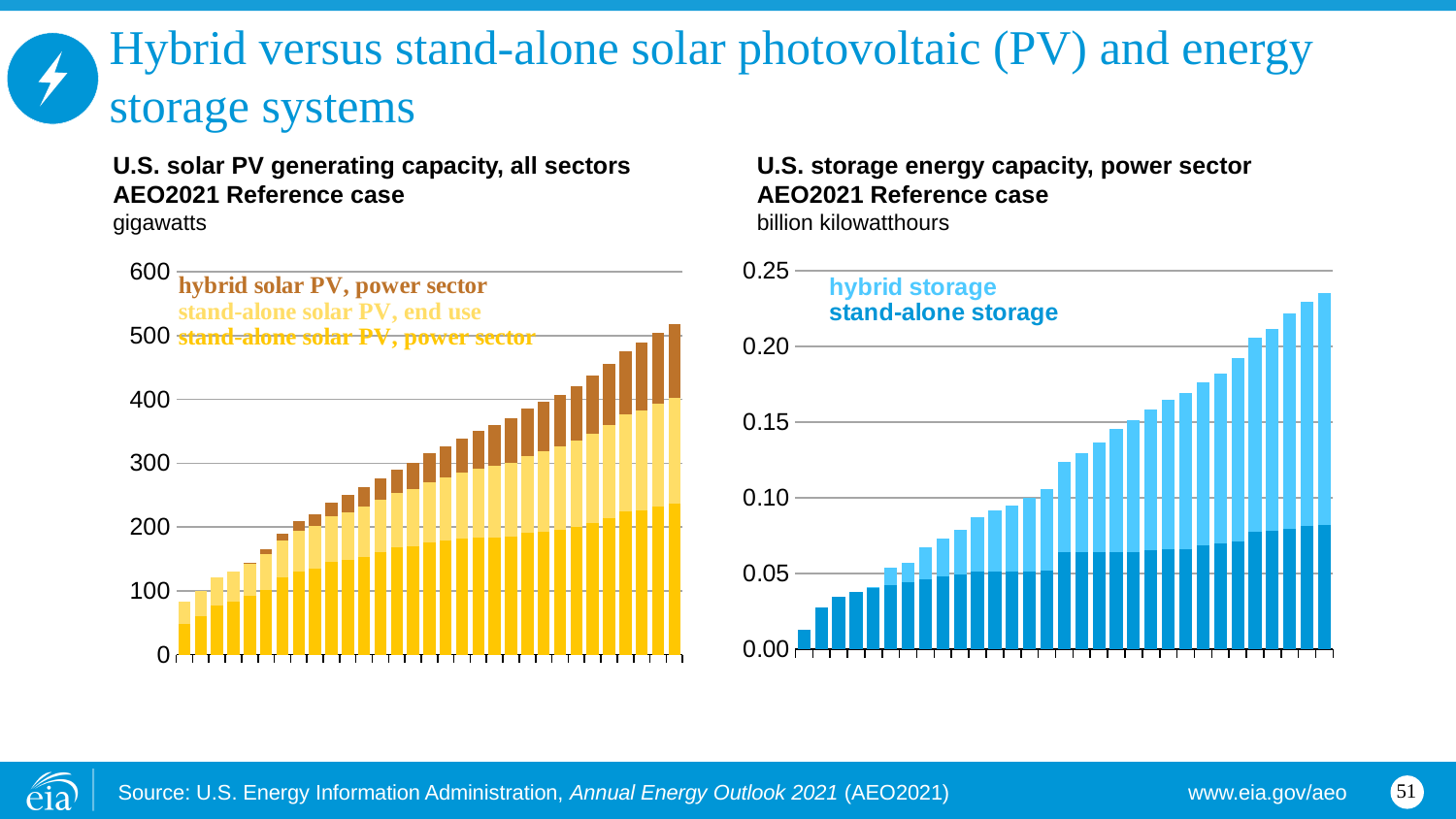
In the right chart, 'U.S. storage energy capacity, power sector', do the total bar heights rise or fall from left to right? Rise How many series does the legend of the right chart, 'U.S. storage energy capacity, power sector', list? 2 In the right chart, 'U.S. storage energy capacity, power sector', which series has the larger segment in the rightmost bar, hybrid storage or stand-alone storage? hybrid storage In the right chart, 'U.S. storage energy capacity, power sector', is the total of the rightmost bar greater or less than 0.20? greater What kind of chart is the left chart, 'U.S. solar PV generating capacity, all sectors'? Stacked bar chart What unit is used on the y axis of the right chart, 'U.S. storage energy capacity, power sector'? billion kilowatthours In the left chart, 'U.S. solar PV generating capacity, all sectors', is the total of the leftmost bar greater or less than 100? less In the left chart, 'U.S. solar PV generating capacity, all sectors', is the total of the rightmost bar greater or less than 400? greater What unit is used on the y axis of the left chart, 'U.S. solar PV generating capacity, all sectors'? gigawatts In the left chart, 'U.S. solar PV generating capacity, all sectors', do the total bar heights rise or fall from left to right? Rise How many series does the legend of the left chart, 'U.S. solar PV generating capacity, all sectors', list? 3